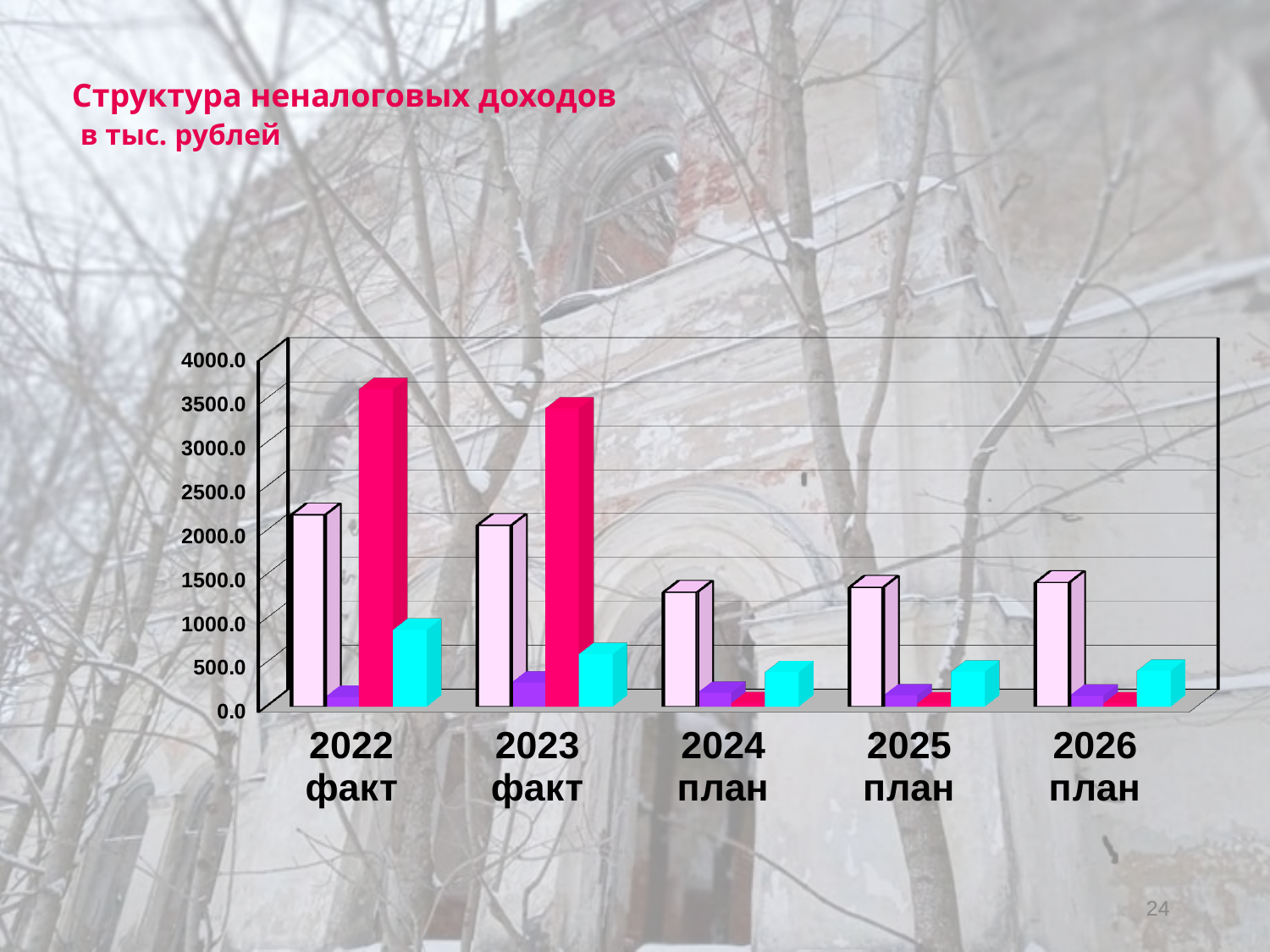
Is the value of the light pink bar for 2022 факт greater or less than 2000.0? greater Is the value of the magenta bar for 2023 факт greater or less than 3000.0? greater Is the value of the cyan bar for 2023 факт greater or less than 500.0? greater How many categories are shown along the x axis of the chart? 5 How many bars are plotted for each category in the chart? 4 What kind of chart is shown on the slide? bar chart In which category is the magenta bar the tallest? 2022 факт For 2022 факт, which is larger: the magenta bar or the light pink bar? the magenta bar What is the title of the chart on the slide? Структура неналоговых доходов в тыс. рублей